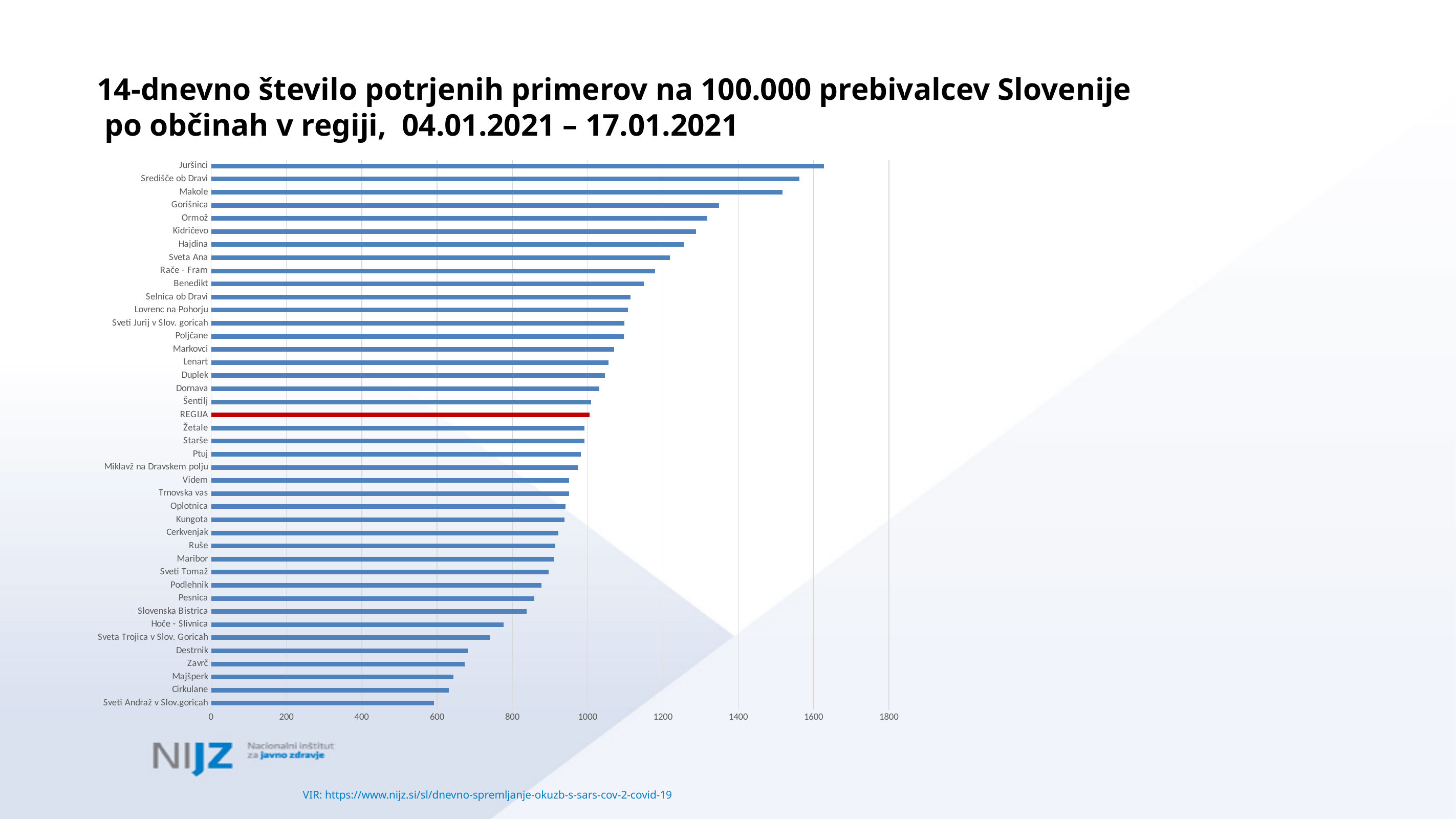
How many bars are plotted in the chart (including REGIJA)? 42 Is the value for Makole greater or less than 1400? greater Which has a higher value, Gorišnica or Ptuj? Gorišnica Which municipality has the highest 14-day number of confirmed cases per 100,000 inhabitants? Juršinci What kind of chart is shown on the slide? bar chart Which bar in the chart is coloured red instead of blue? REGIJA Is the value for Hoče - Slivnica greater or less than 800? less Is the value for Maribor greater or less than 800? greater Which municipality has the lowest 14-day number of confirmed cases per 100,000 inhabitants? Sveti Andraž v Slov.goricah Which has a higher value, Makole or Maribor? Makole